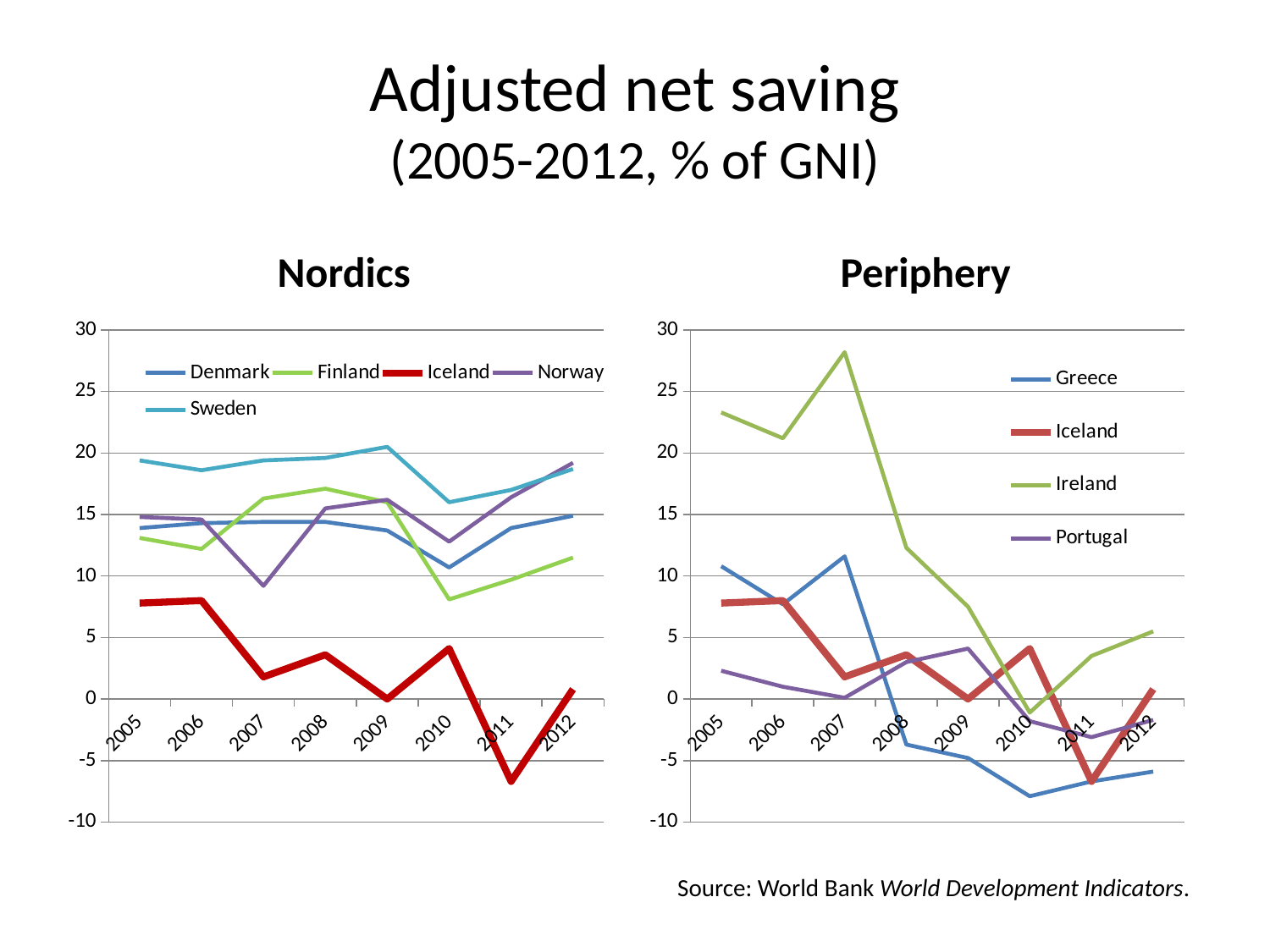
In the Periphery chart, is the value for Ireland in 2007 greater or less than 25? greater In the Periphery chart, which country has the highest value in 2007? Ireland In the Periphery chart, does the value for Greece generally rise or fall from 2005 to 2012? fall How many years are plotted along the x axis of the Periphery chart? 8 In the Nordics chart, which country has the highest value in 2009? Sweden In the Nordics chart, is the value for Iceland in 2011 greater or less than -5? less How many series does the legend of the Nordics chart list? 5 In the Nordics chart, which country has the lowest value in 2011? Iceland How many series does the legend of the Periphery chart list? 4 In the Nordics chart, is the value for Finland in 2010 greater or less than 10? less What kind of chart is the Nordics chart? line chart In the Periphery chart, which country has the lowest value in 2010? Greece